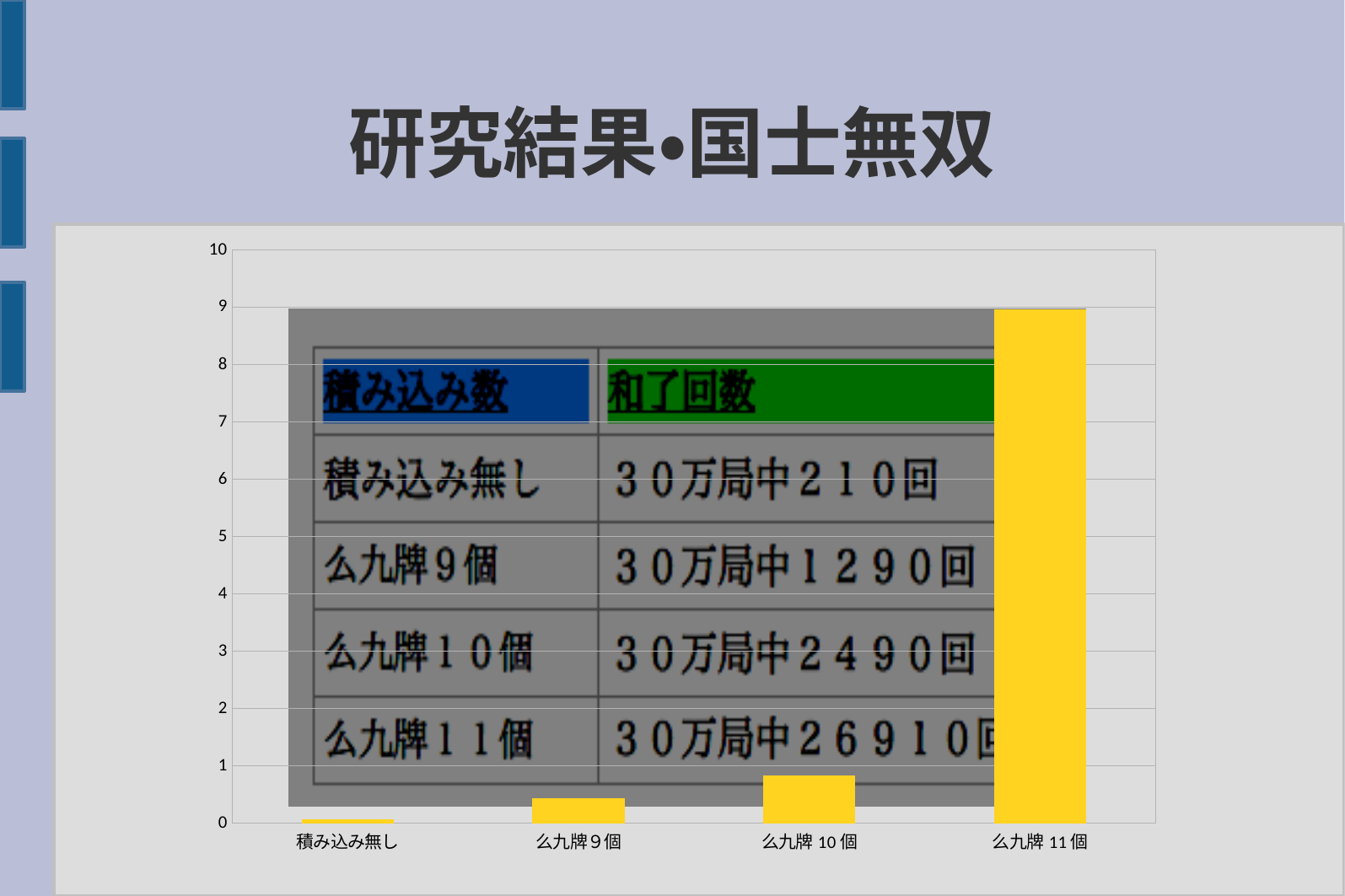
Is the value for 么九牌 10 個 greater or less than 1? less Which category has the highest bar in the chart? 么九牌 11 個 Is the value for 么九牌９個 greater or less than 1? less What colour are the bars in the chart? yellow Do the bar values rise or fall from left to right along the x axis? rise What is the title of the slide containing the chart? 研究結果•国士無双 Which category has the lowest bar in the chart? 積み込み無し Is the value for 積み込み無し greater or less than 1? less How many categories are plotted on the x axis of the chart? 4 Which is larger, the value for 么九牌 10 個 or the value for 么九牌９個? 么九牌 10 個 What kind of chart is shown on the slide? bar chart